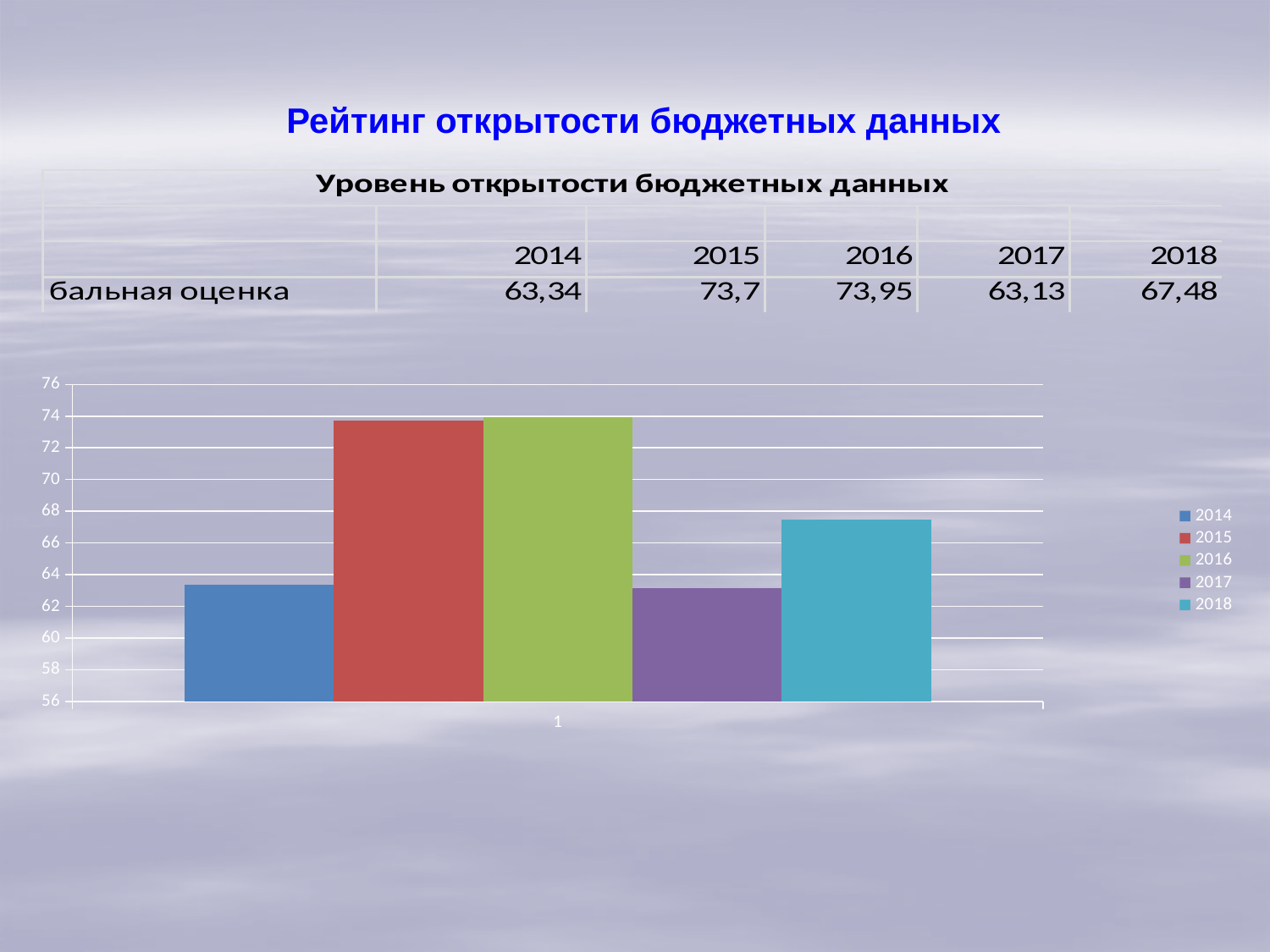
What is the value (бальная оценка) for 2018? 67,48 What is the title of the table above the chart? Уровень открытости бюджетных данных What is the value (бальная оценка) for 2016? 73,95 Which year has the highest value? 2016 How many series does the chart legend list? 5 Which is larger, the value for 2018 or the value for 2014? 2018 Is the value for 2017 greater or less than 66? less What kind of chart is shown on the slide? bar chart Is the value for 2015 greater or less than 70? greater What is the difference between the values for 2016 and 2017? 10,82 Which year has the lowest value? 2017 What is the value (бальная оценка) for 2014? 63,34